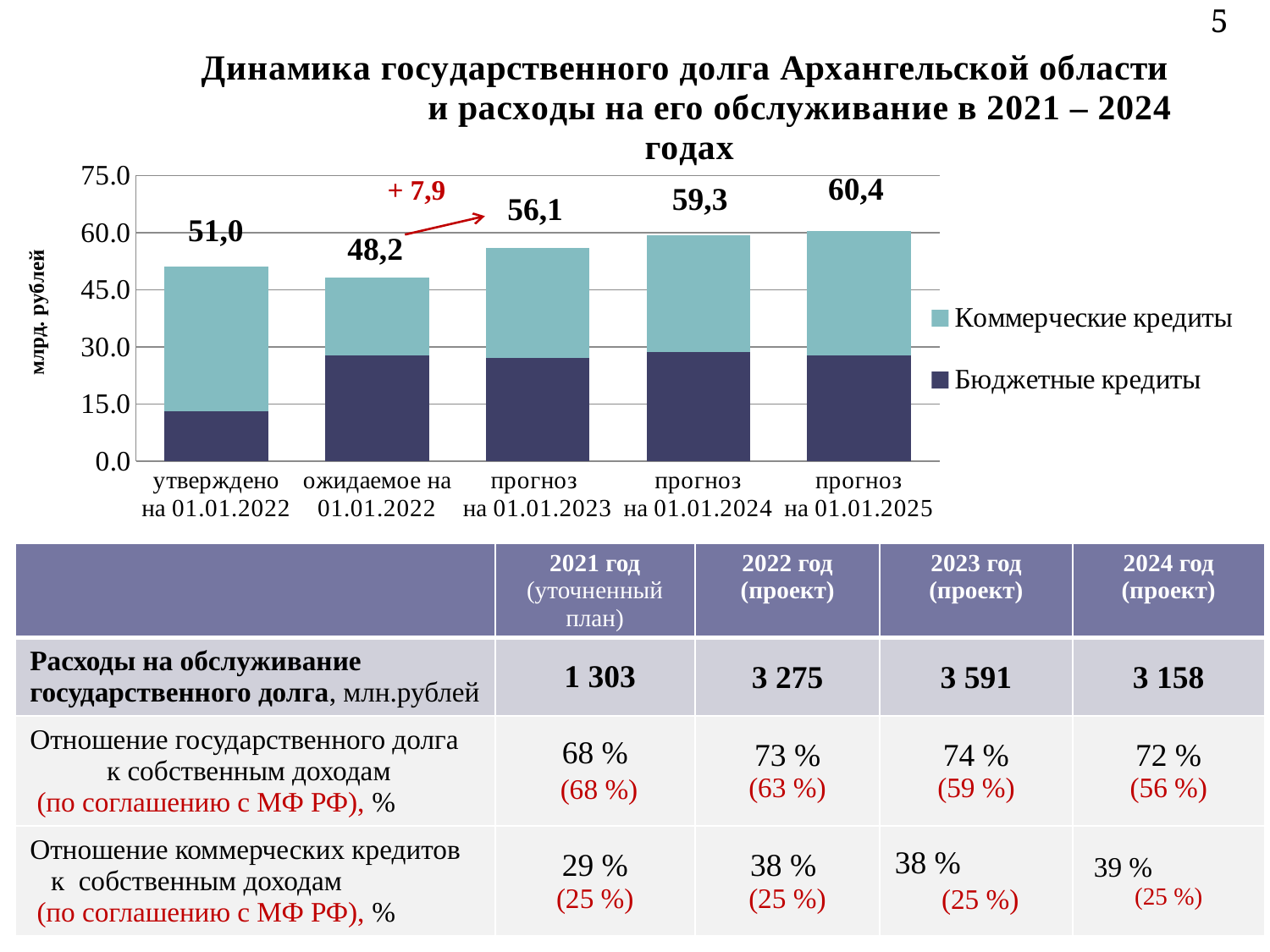
Which bar has the lowest total state debt? ожидаемое на 01.01.2022 By how much does the total for 'прогноз на 01.01.2023' exceed the total for 'ожидаемое на 01.01.2022'? 7,9 How many series does the chart legend list? 2 Which total is larger: 'прогноз на 01.01.2024' or 'прогноз на 01.01.2023'? прогноз на 01.01.2024 Is the value of 'Бюджетные кредиты' for 'утверждено на 01.01.2022' greater or less than 15.0? less What is the total state debt shown for the bar labelled 'утверждено на 01.01.2022'? 51,0 How many bars are plotted in the chart? 5 What type of chart is shown on the slide? stacked bar chart What is the total state debt shown for 'прогноз на 01.01.2025'? 60,4 What is the total state debt shown for 'ожидаемое на 01.01.2022'? 48,2 Which bar has the highest total state debt? прогноз на 01.01.2025 From 'ожидаемое на 01.01.2022' to 'прогноз на 01.01.2025', do the total values rise or fall? rise